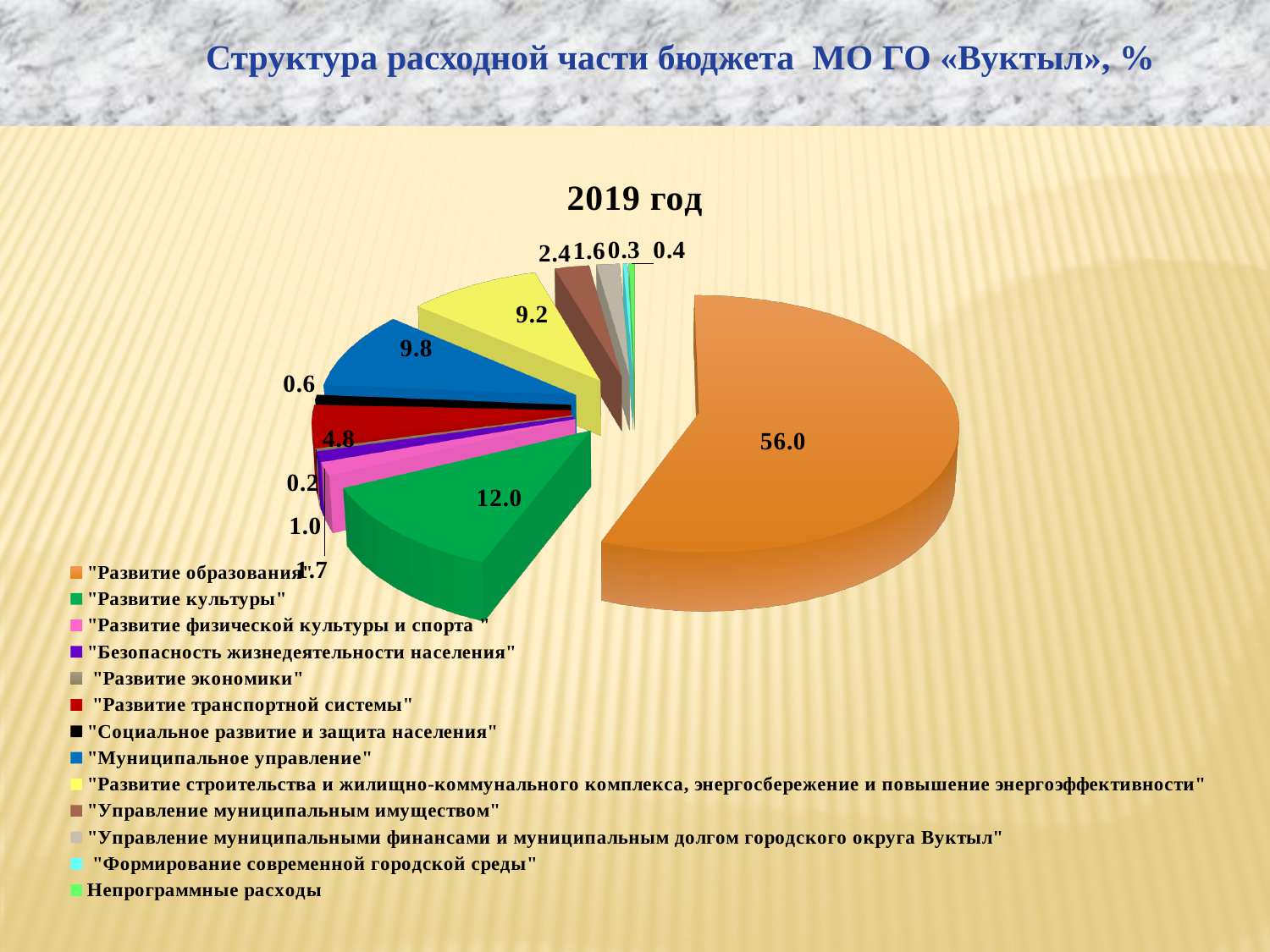
What is the value for "Развитие культуры"? 12.0 How many categories does the legend list? 13 What kind of chart is shown on the slide? pie chart What is the value for "Развитие строительства и жилищно-коммунального комплекса, энергосбережение и повышение энергоэффективности"? 9.2 What is the value for "Развитие транспортной системы"? 4.8 What is the smallest value labelled on the pie? 0.2 What is the value for "Развитие образования"? 56.0 What is the value for "Муниципальное управление"? 9.8 Which is larger, the value for "Муниципальное управление" or the value for "Развитие транспортной системы"? "Муниципальное управление" Which category has the largest slice of the pie? "Развитие образования" What is the difference between the values for "Развитие образования" and "Развитие культуры"? 44.0 What is the title of the chart? 2019 год